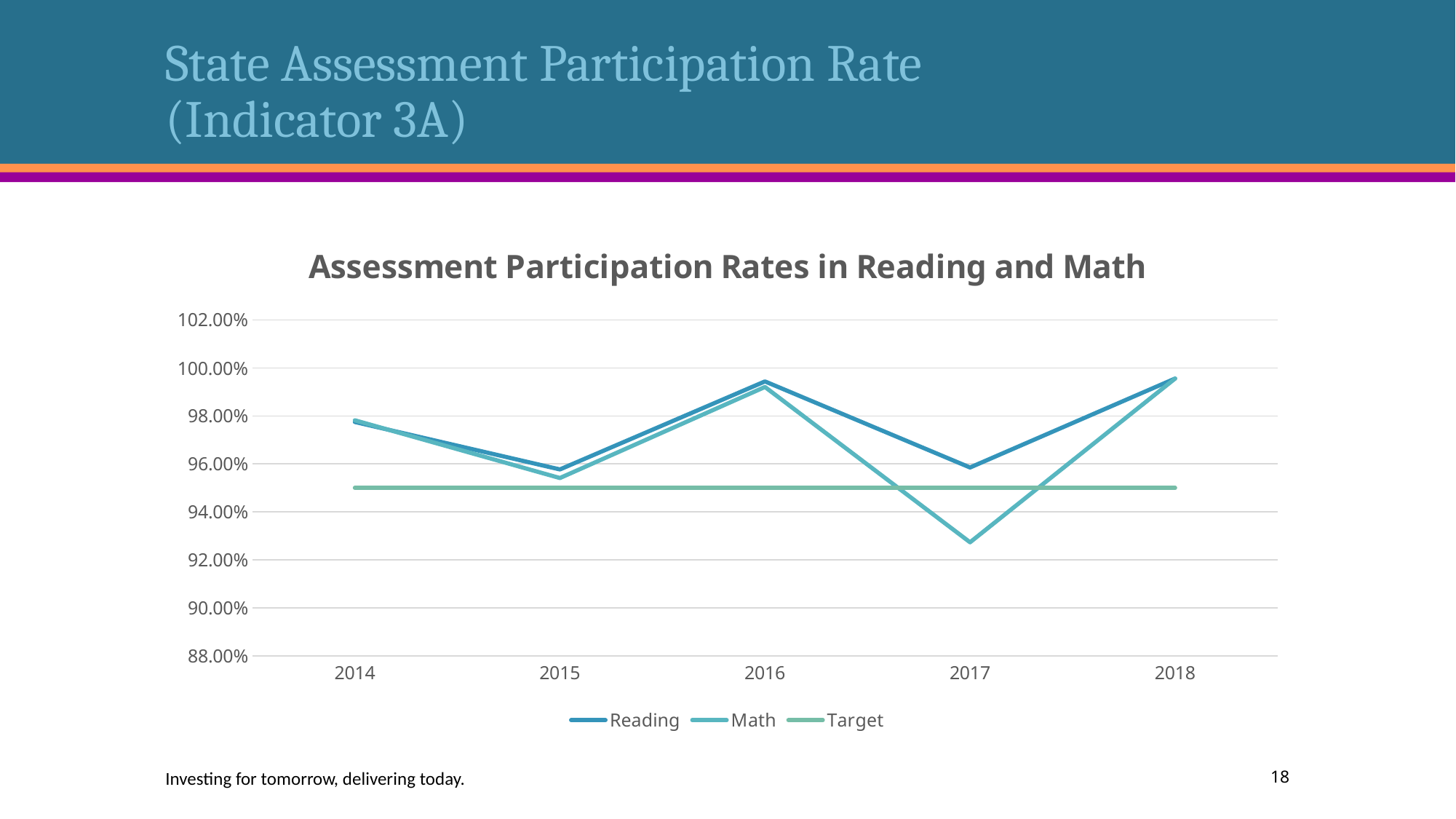
What type of chart is shown on the slide? line chart How many years are shown on the x axis? 5 Is the Reading value for 2018 greater or less than 98.00%? greater Does the Reading line rise or fall from 2017 to 2018? rise In 2017, which is larger, the Reading rate or the Math rate? Reading Is the Math value for 2016 greater or less than 98.00%? greater Is the Math value for 2017 greater or less than 94.00%? less In which year is the Math participation rate lowest? 2017 What is the title of the chart? Assessment Participation Rates in Reading and Math Does the Math line rise or fall from 2016 to 2017? fall How many series does the legend list? 3